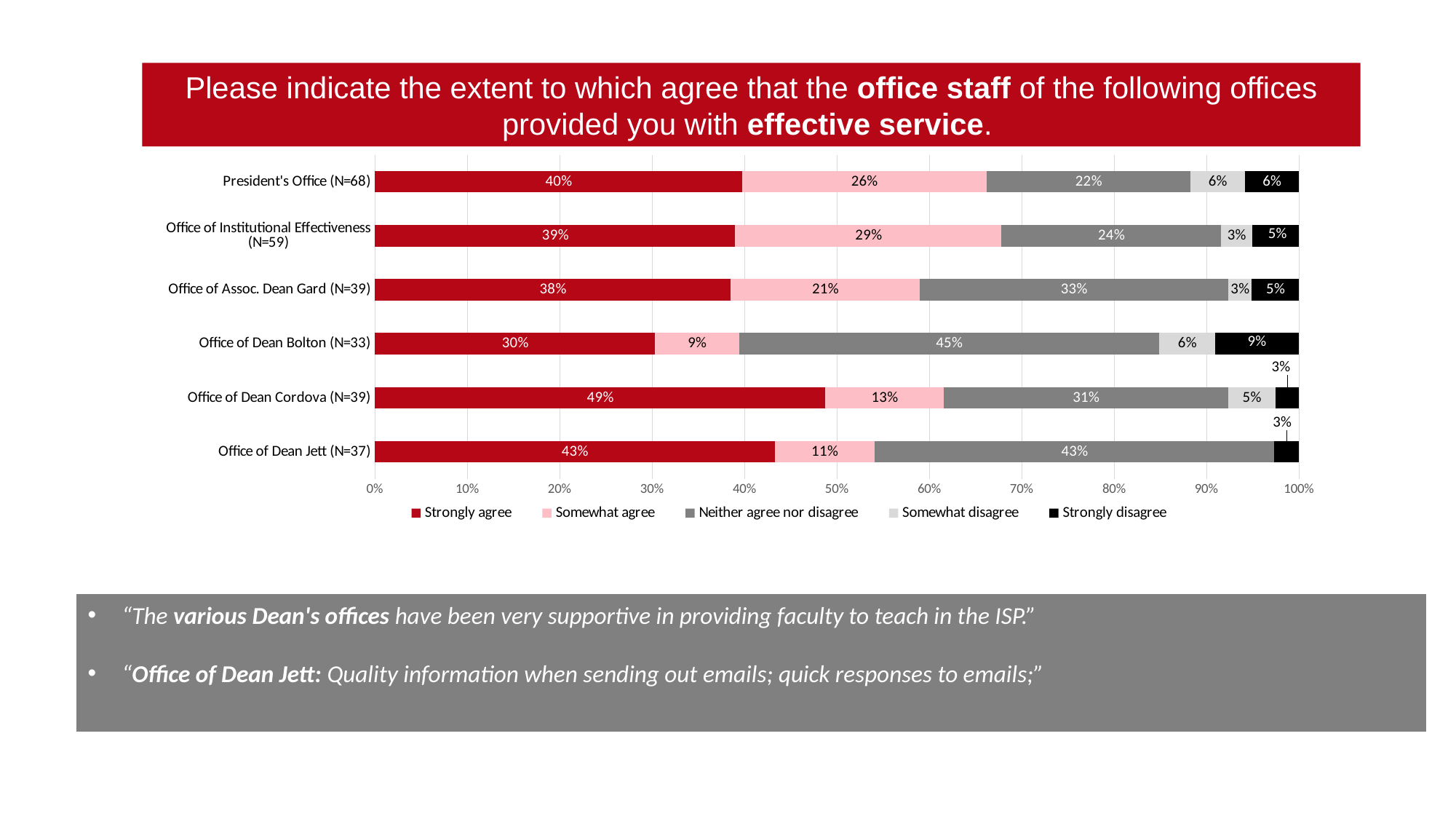
What percentage of respondents strongly agree that the President's Office (N=68) staff provided effective service? 40% What is the 'Neither agree nor disagree' value for the Office of Dean Bolton (N=33)? 45% What colour represents 'Strongly agree' in the chart? Dark red What type of chart is shown on the slide? Stacked bar chart What is the 'Somewhat agree' value for the Office of Dean Jett (N=37)? 11% How many offices are shown in the chart? 6 What is the 'Strongly disagree' value for the Office of Dean Bolton (N=33)? 9% Which office has the highest 'Strongly agree' percentage? Office of Dean Cordova (N=39) How many percentage points higher is the 'Strongly agree' value for the Office of Dean Cordova (N=39) than for the Office of Dean Bolton (N=33)? 19 percentage points How many response categories does the legend list? 5 Which has a larger 'Somewhat agree' value: the Office of Institutional Effectiveness (N=59) or the President's Office (N=68)? Office of Institutional Effectiveness (N=59) Which office has the lowest 'Strongly agree' percentage? Office of Dean Bolton (N=33)